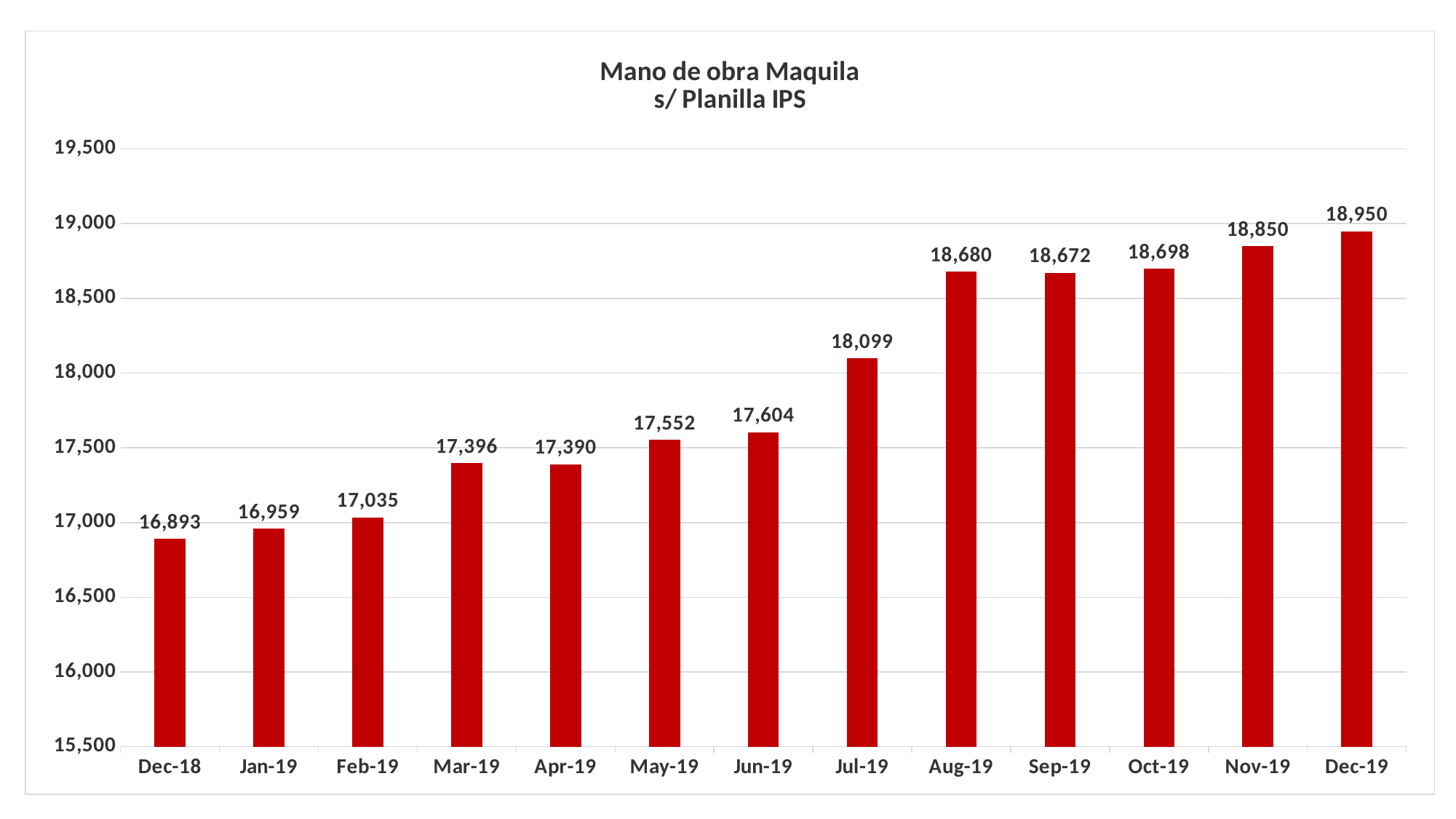
Which month has the highest value? Dec-19 Which month has the lowest value? Dec-18 How many months are shown on the x axis? 13 What kind of chart is this? bar chart What is the difference between the values for Aug-19 and Jul-19? 581 Is the value for Nov-19 greater or less than 18,500? greater What is the value for Mar-19? 17,396 What is the difference between the values for Dec-19 and Dec-18? 2,057 Do the values generally rise or fall from Dec-18 to Dec-19? rise Which is larger, the value for Jun-19 or the value for May-19? Jun-19 What is the value for Dec-18? 16,893 What is the value for Jul-19? 18,099